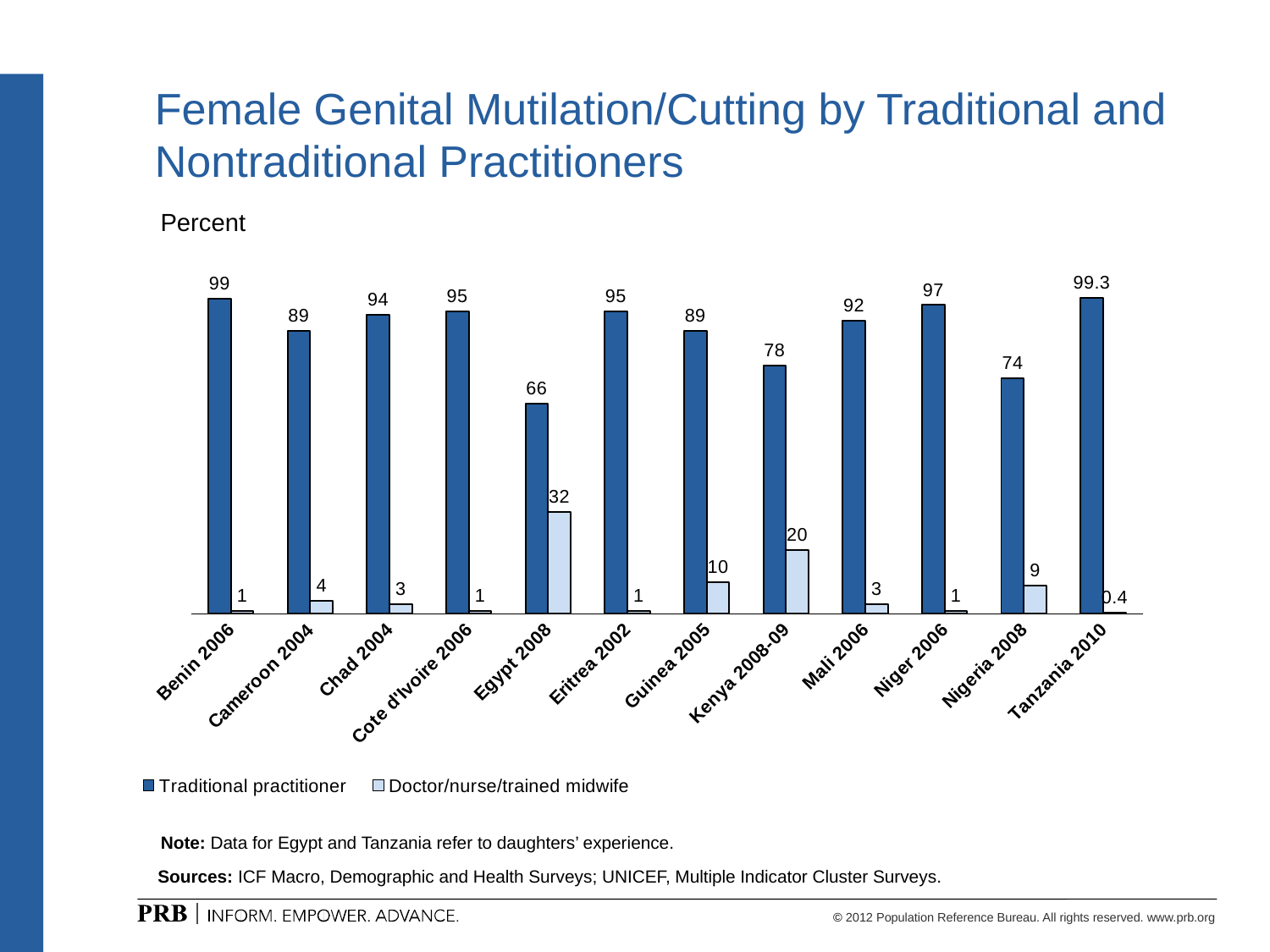
What is the difference between the Traditional practitioner values for Benin 2006 and Nigeria 2008? 25 Which country has the lowest value for Traditional practitioner? Egypt 2008 How many series does the legend list? 2 What kind of chart is shown on the slide? Bar chart What is the value for Traditional practitioner in Egypt 2008? 66 Which is larger: the Traditional practitioner value for Mali 2006 or for Kenya 2008-09? Mali 2006 What is the total of the Traditional practitioner and Doctor/nurse/trained midwife values for Egypt 2008? 98 How many countries are shown on the x axis? 12 What unit is indicated above the chart? Percent What is the value for Doctor/nurse/trained midwife in Kenya 2008-09? 20 What is the value for Traditional practitioner in Tanzania 2010? 99.3 Which country has the highest value for Doctor/nurse/trained midwife? Egypt 2008